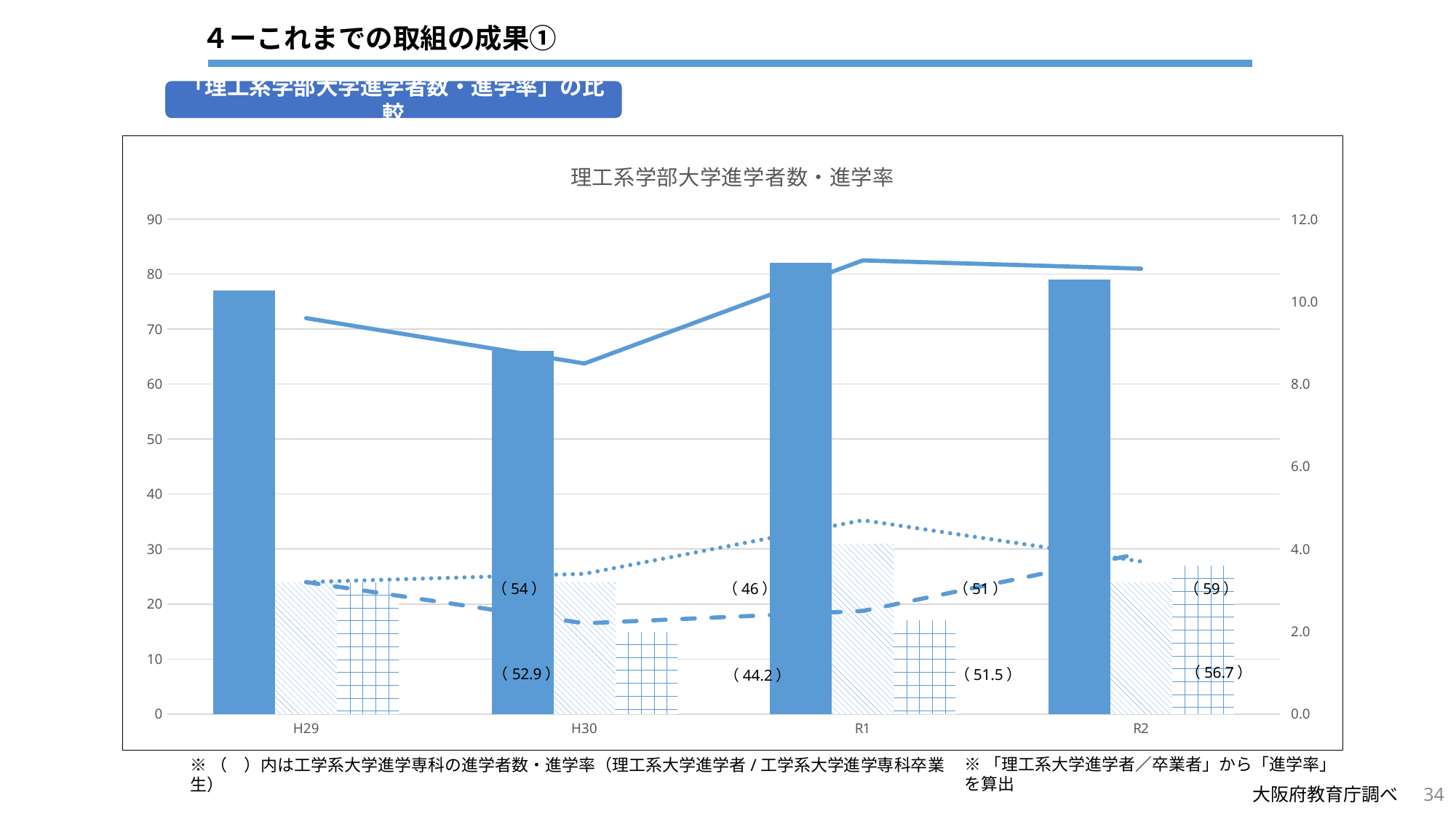
Is the solid blue bar for H30 greater or less than 70 on the left axis? less Is the solid blue bar for R1 greater or less than 80 on the left axis? greater Which category has the tallest solid blue bar? R1 Is the solid blue bar for H29 greater or less than 70 on the left axis? greater What is the title of the chart? 理工系学部大学進学者数・進学率 How many categories are shown on the x axis of the chart? 4 What is the largest value printed in parentheses on the chart? ( 59 ) What kind of chart is shown on the slide? Combined bar and line chart Which category has the shortest solid blue bar? H30 What is the highest tick value shown on the right-hand axis? 12.0 Which solid blue bar is taller, H29 or R2? R2